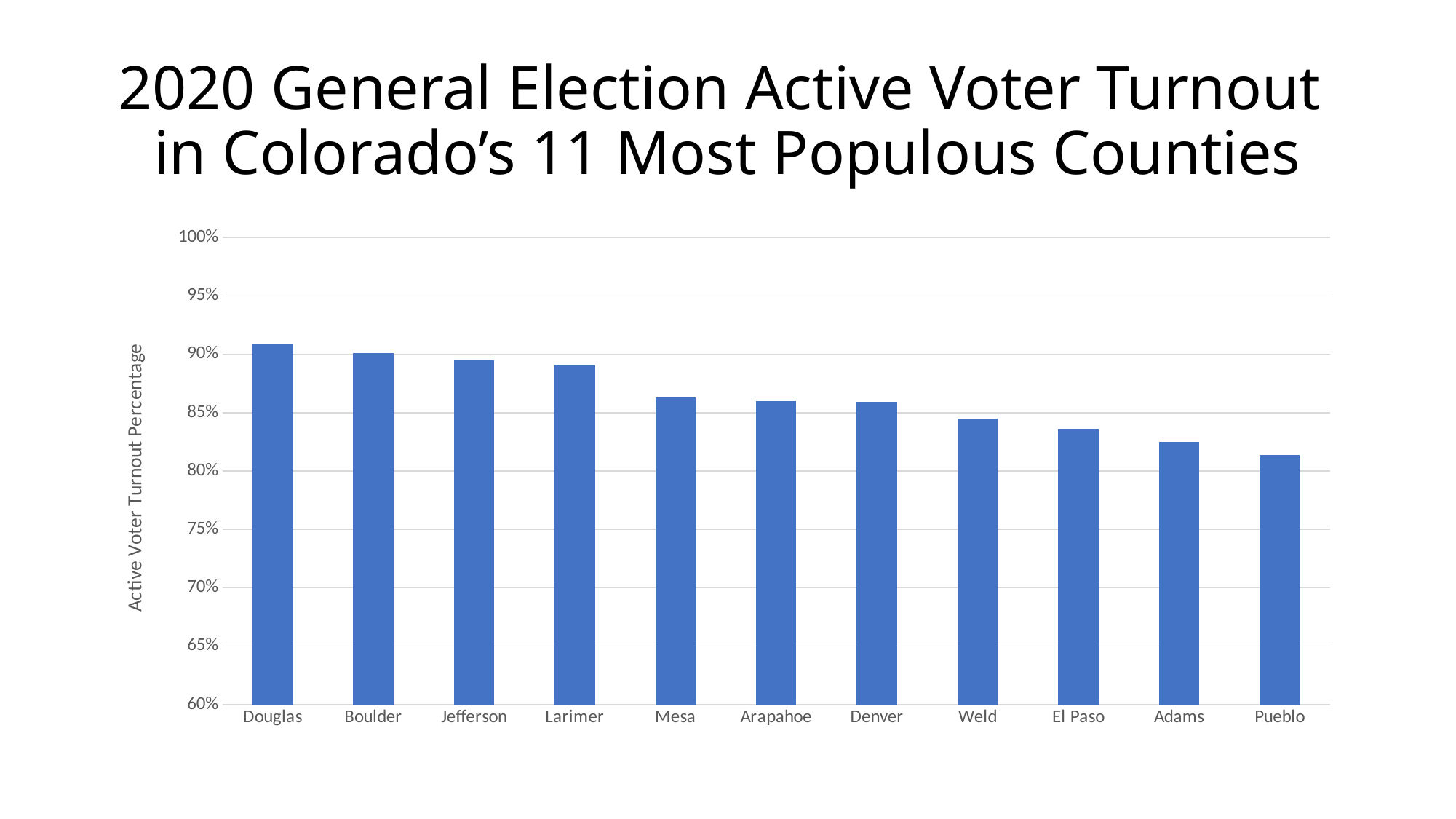
Do the values rise or fall moving from left to right along the x axis? fall What is the label on the vertical axis of the chart? Active Voter Turnout Percentage Is the value for Douglas greater or less than 90%? greater Is the value for Pueblo greater or less than 85%? less Which county has the highest active voter turnout percentage? Douglas How many counties are shown on the x axis of the chart? 11 Is the value for El Paso greater or less than 85%? less Which has a higher active voter turnout percentage, Boulder or Mesa? Boulder Which county has the lowest active voter turnout percentage? Pueblo What kind of chart is shown on the slide? bar chart